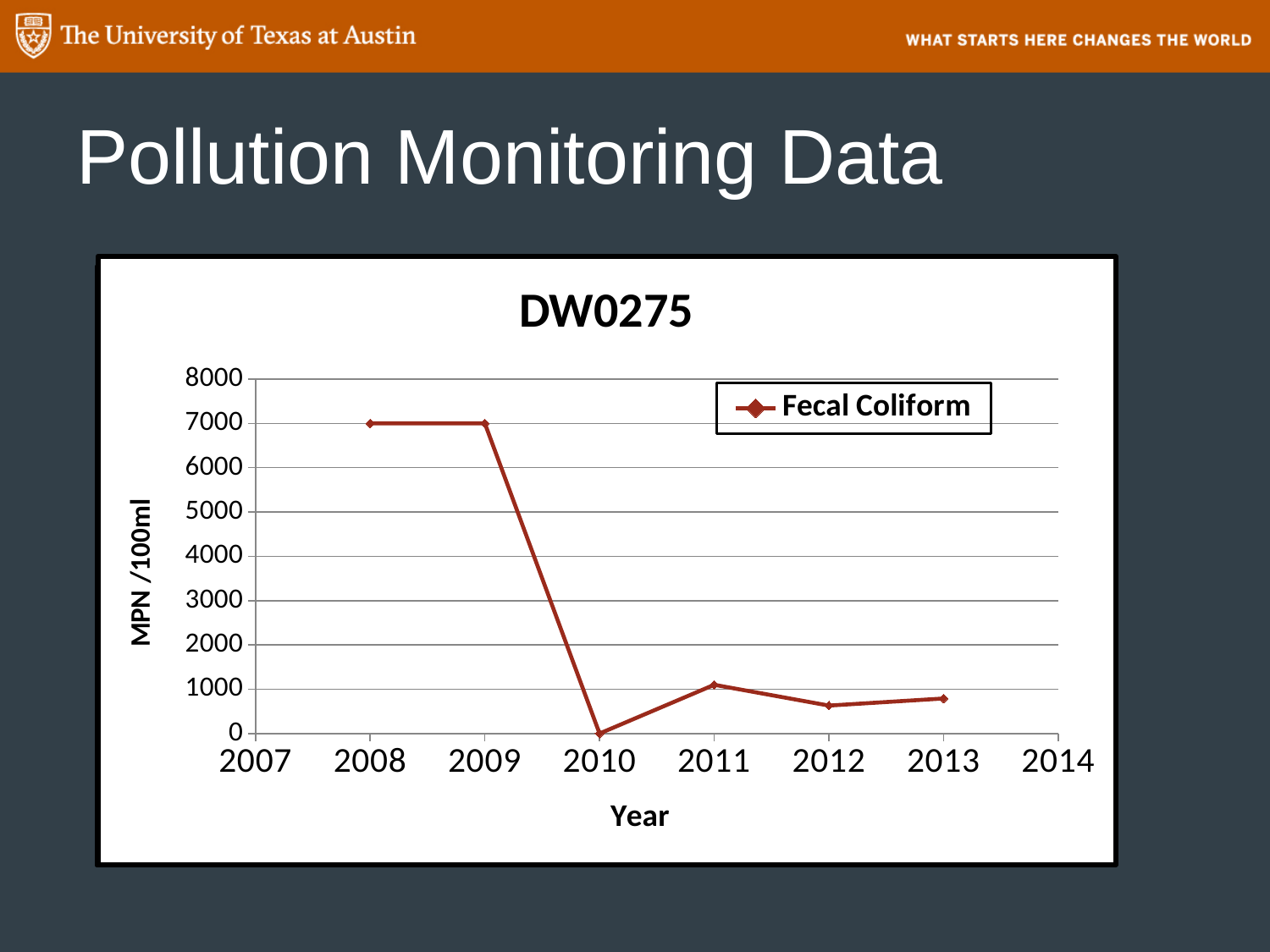
What kind of chart is shown on the slide? line chart How many series does the legend list? 1 What is the difference between the Fecal Coliform values for 2008 and 2010? 7000 Is the Fecal Coliform value for 2012 greater or less than 1000? less What is the Fecal Coliform value for 2008? 7000 What is the Fecal Coliform value for 2010? 0 Is the Fecal Coliform value for 2011 greater or less than 2000? less How many data points are plotted for Fecal Coliform? 6 What is the title of the chart? DW0275 Which year has the lowest Fecal Coliform value? 2010 Does the Fecal Coliform value rise or fall from 2009 to 2010? fall Which year has the larger Fecal Coliform value, 2009 or 2011? 2009